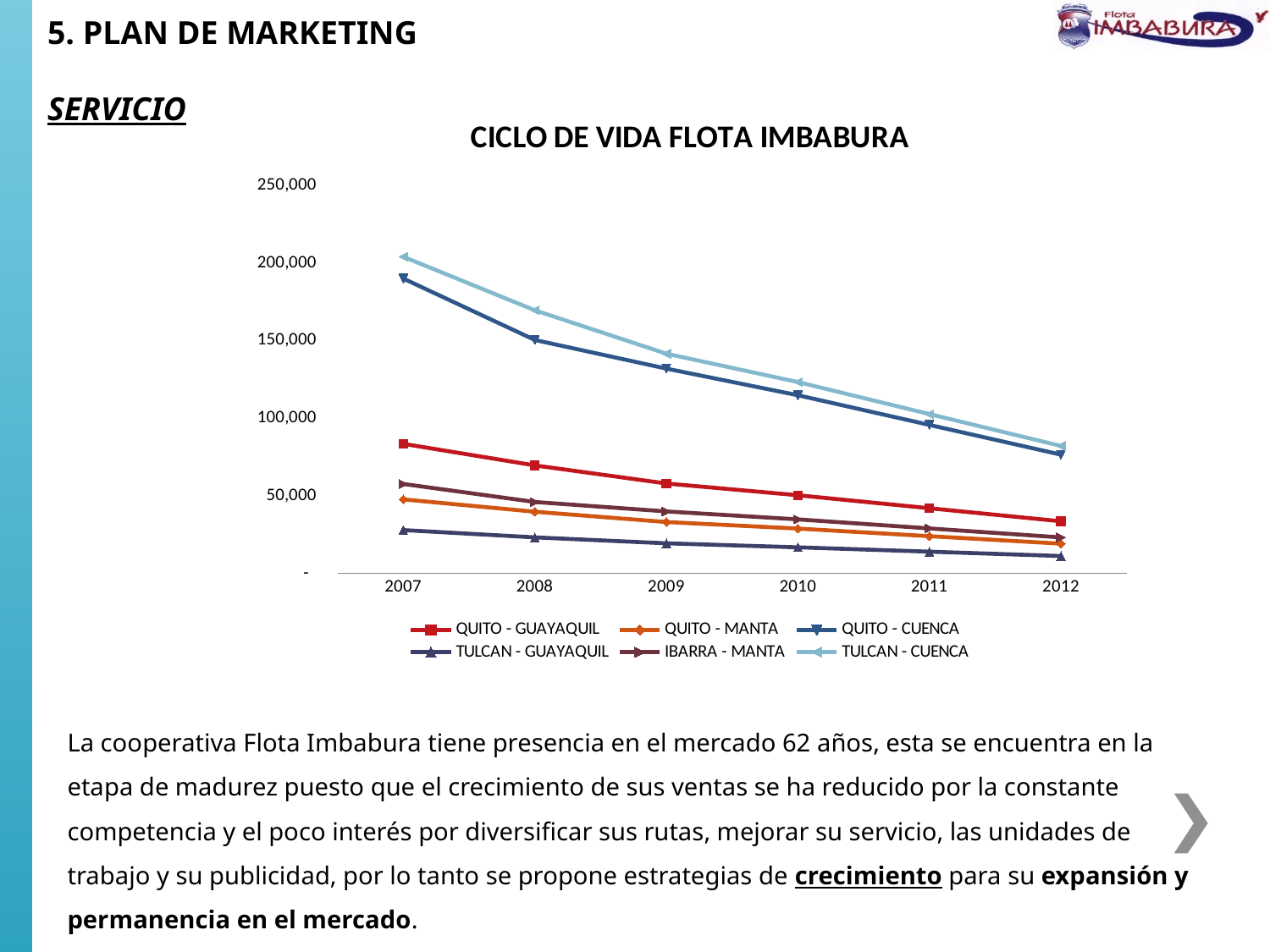
Which series has the highest value in 2007? TULCAN - CUENCA Is the value for QUITO - CUENCA in 2007 greater or less than 200,000? less How many years are shown on the x axis? 6 Do the values for QUITO - CUENCA rise or fall from 2007 to 2012? fall What is the title of the chart? CICLO DE VIDA FLOTA IMBABURA Is the value for QUITO - GUAYAQUIL in 2007 greater or less than 50,000? greater What kind of chart is shown on the slide? line chart In 2007, which is larger: QUITO - GUAYAQUIL or QUITO - MANTA? QUITO - GUAYAQUIL How many series does the legend list? 6 Is the value for TULCAN - CUENCA in 2012 greater or less than 100,000? less Which series has the lowest value in 2012? TULCAN - GUAYAQUIL